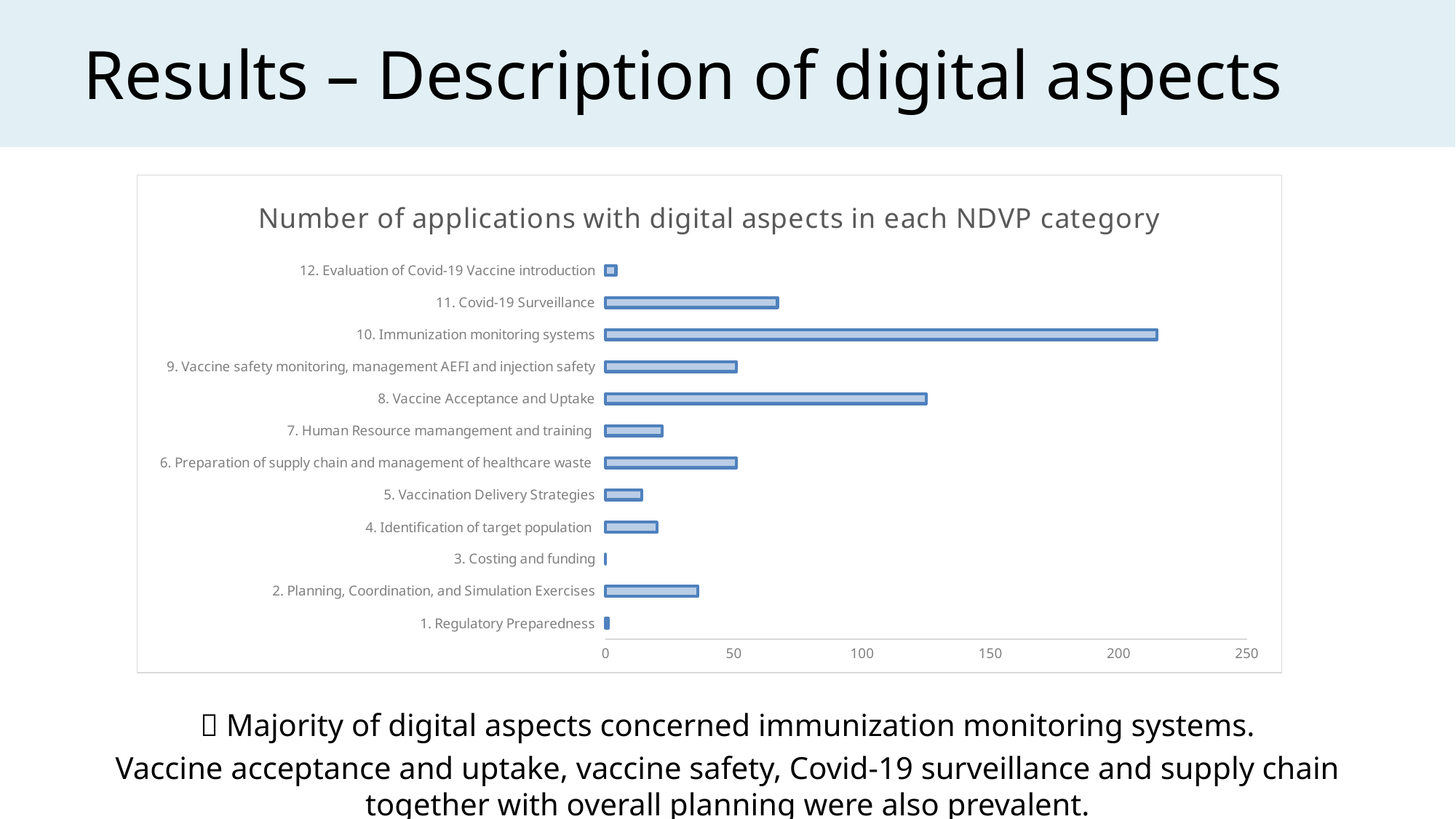
Which has more applications with digital aspects: 8. Vaccine Acceptance and Uptake or 11. Covid-19 Surveillance? 8. Vaccine Acceptance and Uptake How many NDVP categories are plotted in the chart? 12 What kind of chart is shown on the slide? bar chart Which category has the highest number of applications with digital aspects? 10. Immunization monitoring systems Is the value for 7. Human Resource mamangement and training greater or less than 50? less Is the value for 2. Planning, Coordination, and Simulation Exercises greater or less than 50? less Is the value for 10. Immunization monitoring systems greater or less than 200? greater Which has more applications with digital aspects: 11. Covid-19 Surveillance or 5. Vaccination Delivery Strategies? 11. Covid-19 Surveillance What is the maximum value shown on the horizontal axis of the chart? 250 What is the title of the chart? Number of applications with digital aspects in each NDVP category